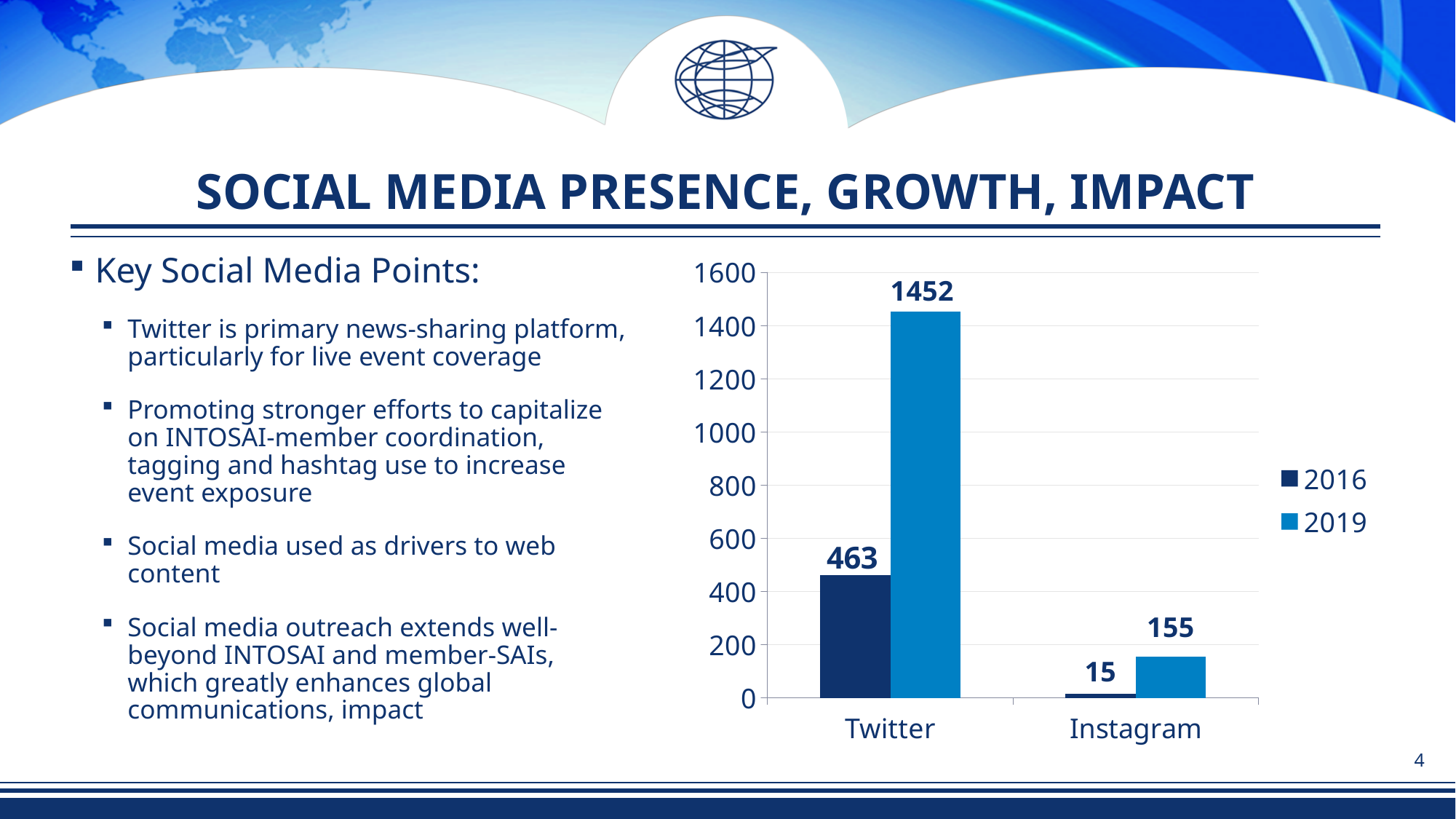
Which platform has the highest value in 2019? Twitter Which platform has the lowest value in 2016? Instagram What is the value for Instagram in 2016? 15 What is the difference between the Twitter values for 2019 and 2016? 989 What is the difference between the Instagram values for 2019 and 2016? 140 How many series does the chart legend list? 2 What is the value for Instagram in 2019? 155 What kind of chart is shown on the slide? Bar chart What is the value for Twitter in 2016? 463 What is the value for Twitter in 2019? 1452 Which is larger: Twitter in 2016 or Instagram in 2019? Twitter in 2016 How many platforms are shown on the x axis of the chart? 2